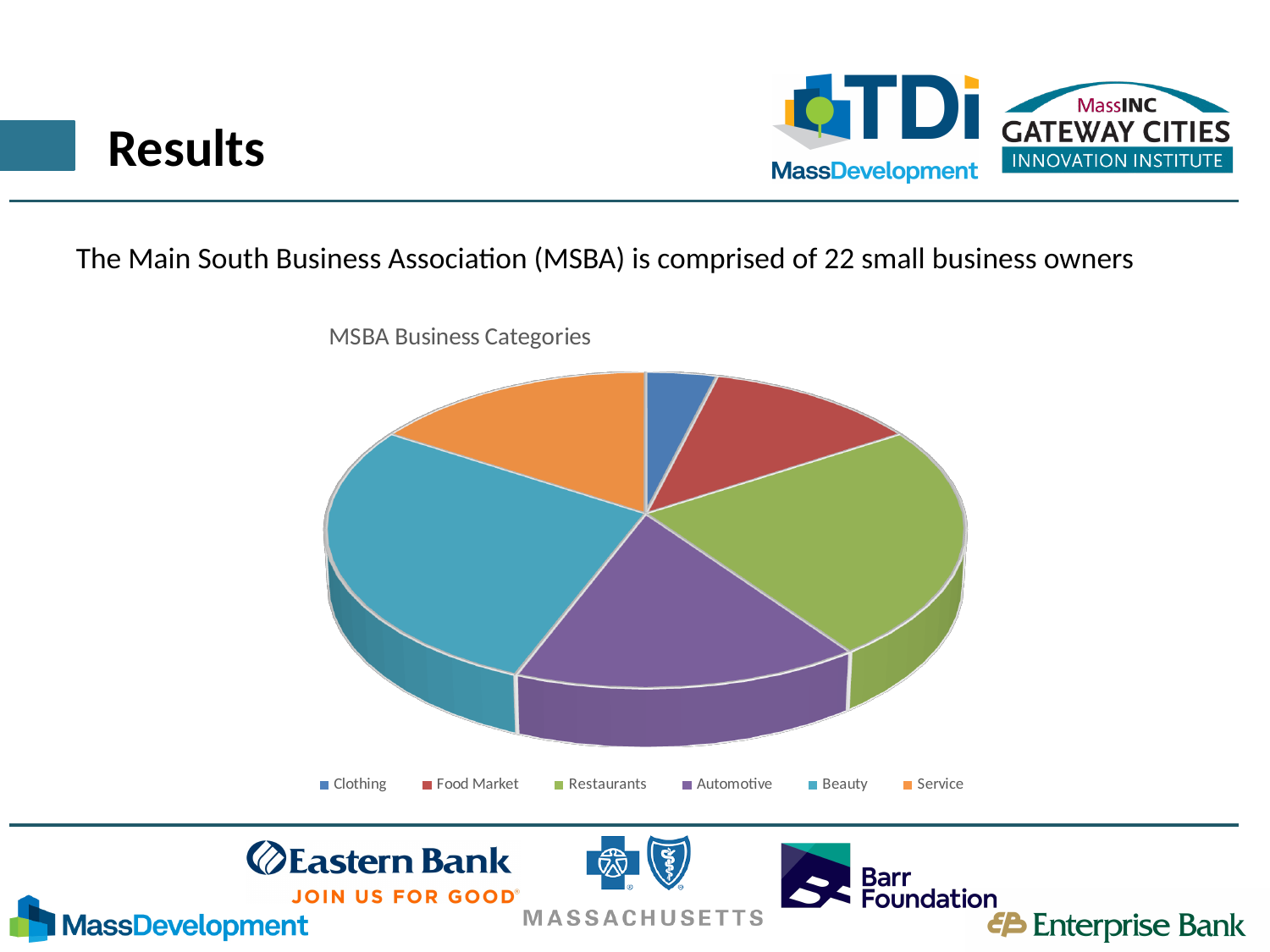
Which slice is larger, Restaurants or Clothing? Restaurants Which category is shown in orange in the legend? Service Which category is listed first in the legend? Clothing Which category has the smallest slice of the pie? Clothing Which slice is larger, Beauty or Clothing? Beauty Which slice is larger, Automotive or Food Market? Automotive What is the title of the chart? MSBA Business Categories How many categories does the pie chart show? 6 What kind of chart is shown on the slide? pie chart